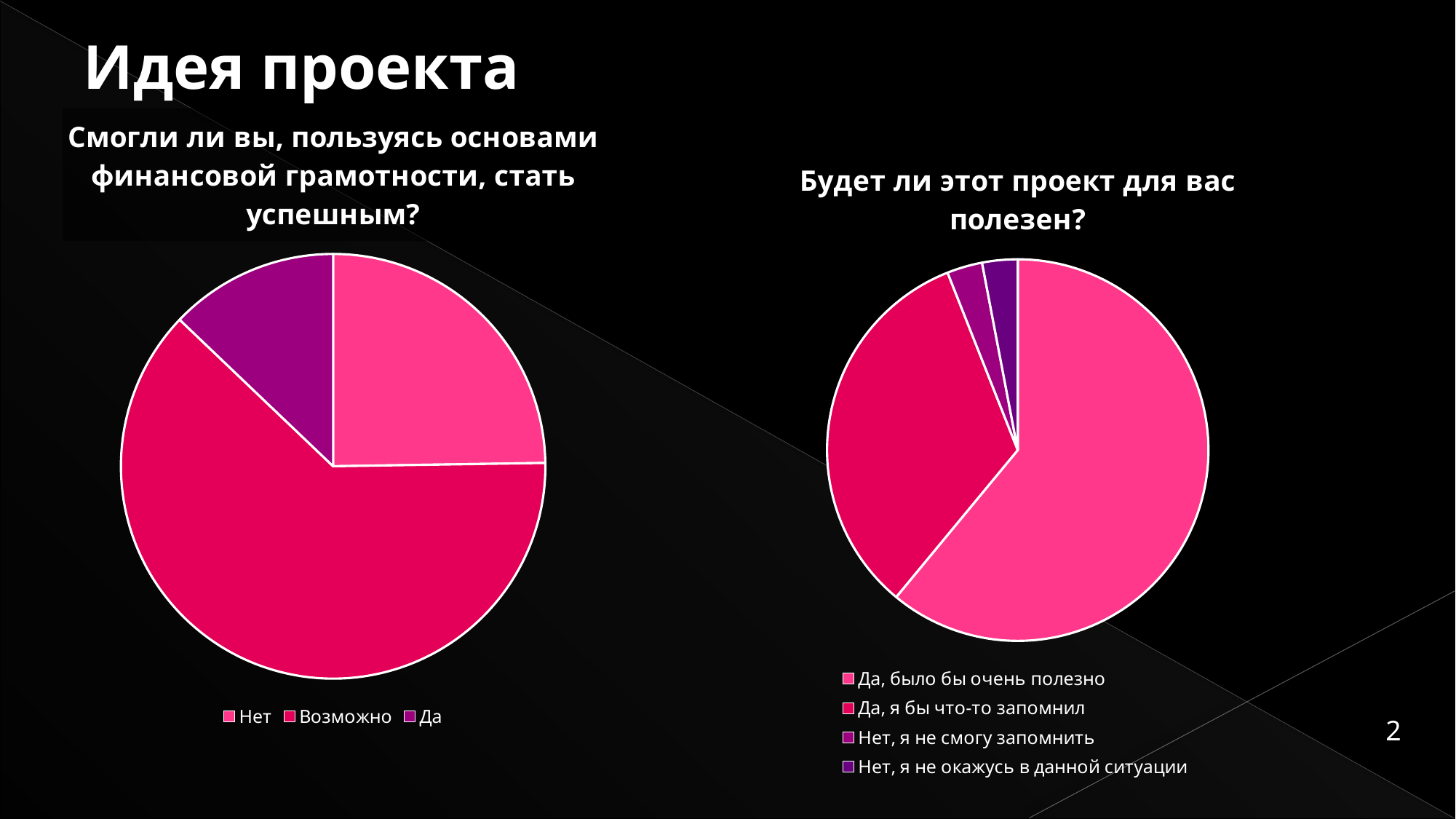
In the left chart ("Смогли ли вы, пользуясь основами финансовой грамотности, стать успешным?"), which category has the largest slice? Возможно In the left chart ("Смогли ли вы, пользуясь основами финансовой грамотности, стать успешным?"), which category has the smallest slice? Да What kind of chart is the chart titled "Будет ли этот проект для вас полезен?"? pie chart In the right chart ("Будет ли этот проект для вас полезен?"), which category has the largest slice? Да, было бы очень полезно In the left chart ("Смогли ли вы, пользуясь основами финансовой грамотности, стать успешным?"), which slice is larger: Нет or Да? Нет In the right chart ("Будет ли этот проект для вас полезен?"), which slice is larger: "Да, я бы что-то запомнил" or "Нет, я не смогу запомнить"? Да, я бы что-то запомнил What is the title of the chart on the right side of the slide? Будет ли этот проект для вас полезен? How many categories does the legend of the left chart ("Смогли ли вы, пользуясь основами финансовой грамотности, стать успешным?") list? 3 What kind of chart is the chart titled "Смогли ли вы, пользуясь основами финансовой грамотности, стать успешным?"? pie chart How many categories does the legend of the right chart ("Будет ли этот проект для вас полезен?") list? 4 How many pie charts are shown on the slide? 2